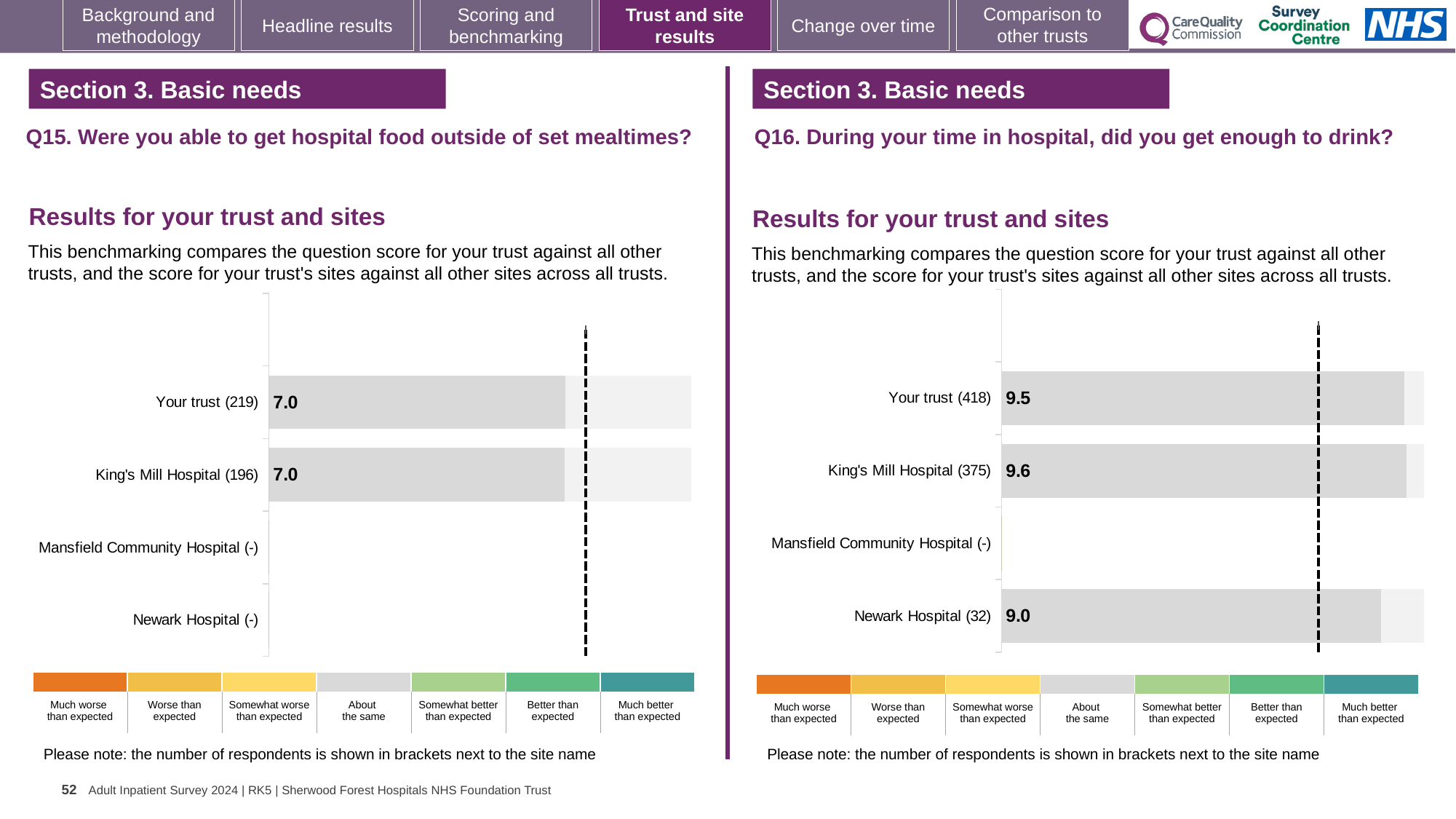
On the Q16 chart (right), which has the larger score, King's Mill Hospital or Newark Hospital? King's Mill Hospital What kind of chart is used on the Q15 chart (left)? Bar chart How many sites (including Your trust) are listed on the Q15 chart (left)? 4 On the Q15 chart (left), what is the score for Your trust? 7.0 On the Q16 chart (right), what is the score for King's Mill Hospital? 9.6 On the Q16 chart (right), which site has the lowest score shown? Newark Hospital On the Q16 chart (right), what is the score for Your trust? 9.5 On the Q16 chart (right), how many respondents are shown in brackets for Your trust? 418 On the Q15 chart (left), what is the score for King's Mill Hospital? 7.0 On the Q16 chart (right), which site has the highest score shown? King's Mill Hospital On the Q16 chart (right), what is the difference between the King's Mill Hospital score and the Newark Hospital score? 0.6 On the Q16 chart (right), what is the score for Newark Hospital? 9.0